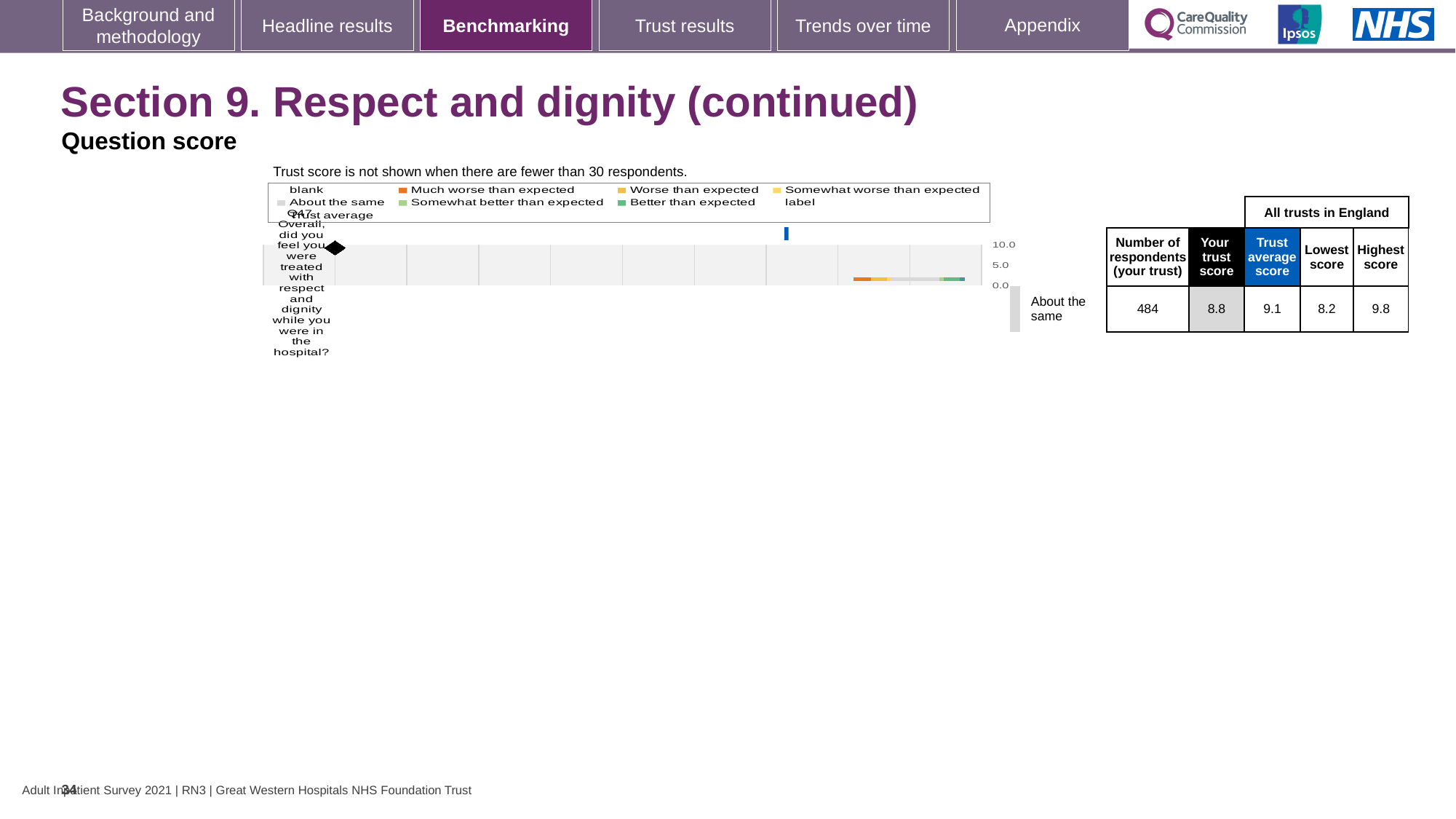
According to the table beside the chart, what is the lowest score among all trusts in England for Q47? 8.2 Which question number is plotted on the chart? Q47 What is the difference between the highest score (9.8) and the lowest score (8.2) for Q47 in the table beside the chart? 1.6 Is the trust's score for Q47 (8.8) larger or smaller than the trust average score (9.1)? smaller How many respondents from the trust answered Q47, according to the table beside the chart? 484 What type of chart is shown on the slide? bar chart How many questions (categories) are plotted on the chart? 1 What benchmark category label is shown next to the chart for Q47? About the same What is the highest tick value shown on the chart's score axis? 10.0 According to the table beside the chart, what is the trust average score for Q47? 9.1 According to the table beside the chart, what is the highest score among all trusts in England for Q47? 9.8 According to the table beside the chart, what is the trust's score for Q47? 8.8